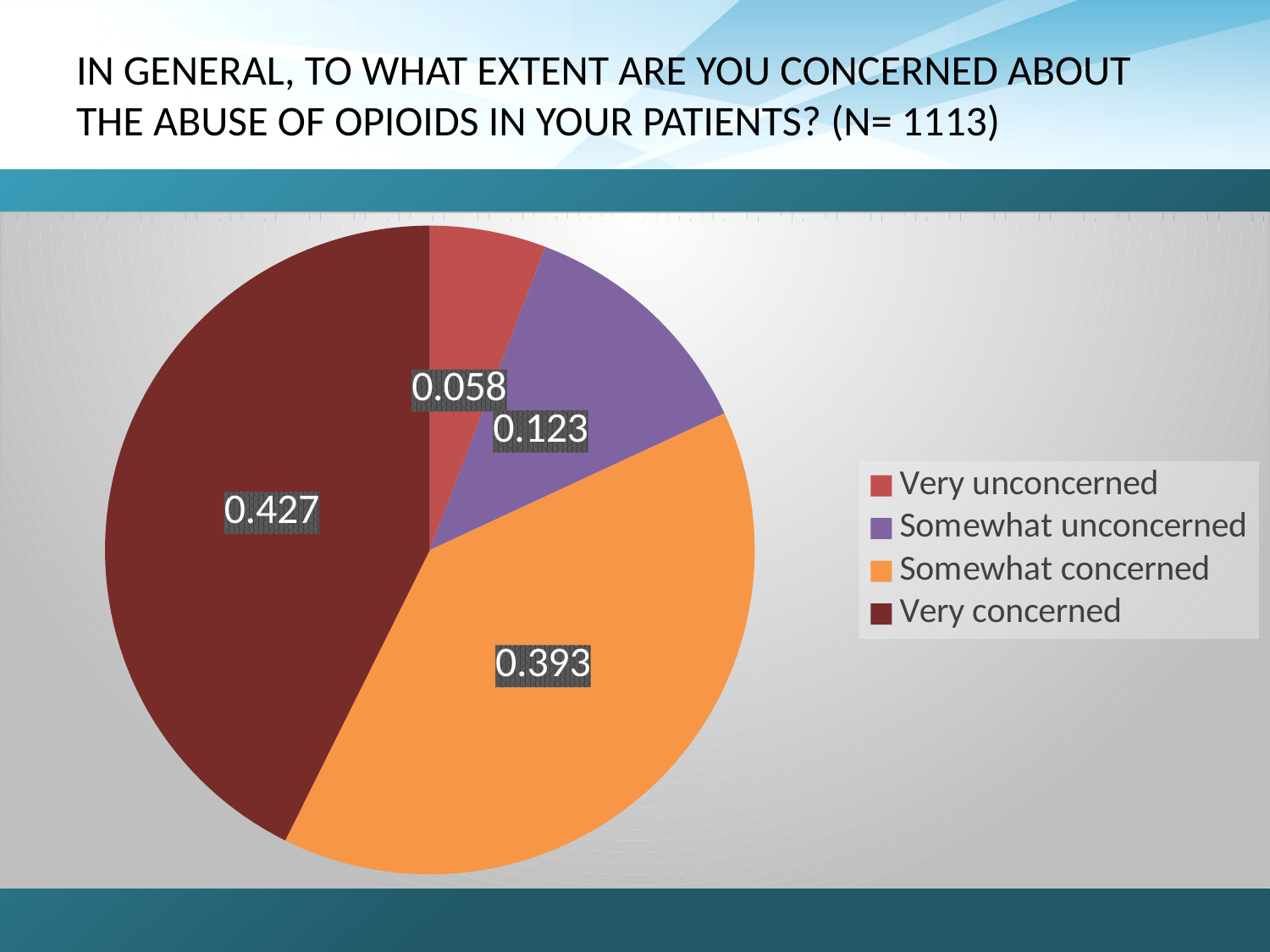
What is the value for Very concerned? 0.427 Which category has the largest slice? Very concerned How many categories does the pie chart have? 4 What colour is the Somewhat concerned slice? orange Which category has the smallest slice? Very unconcerned What type of chart is shown on the slide? pie chart What is the difference between the values for Very concerned and Somewhat concerned? 0.034 What is the difference between the values for Somewhat unconcerned and Very unconcerned? 0.065 What is the value for Somewhat concerned? 0.393 Which is larger, the value for Somewhat unconcerned or the value for Very unconcerned? Somewhat unconcerned What is the value for Very unconcerned? 0.058 What is the value for Somewhat unconcerned? 0.123